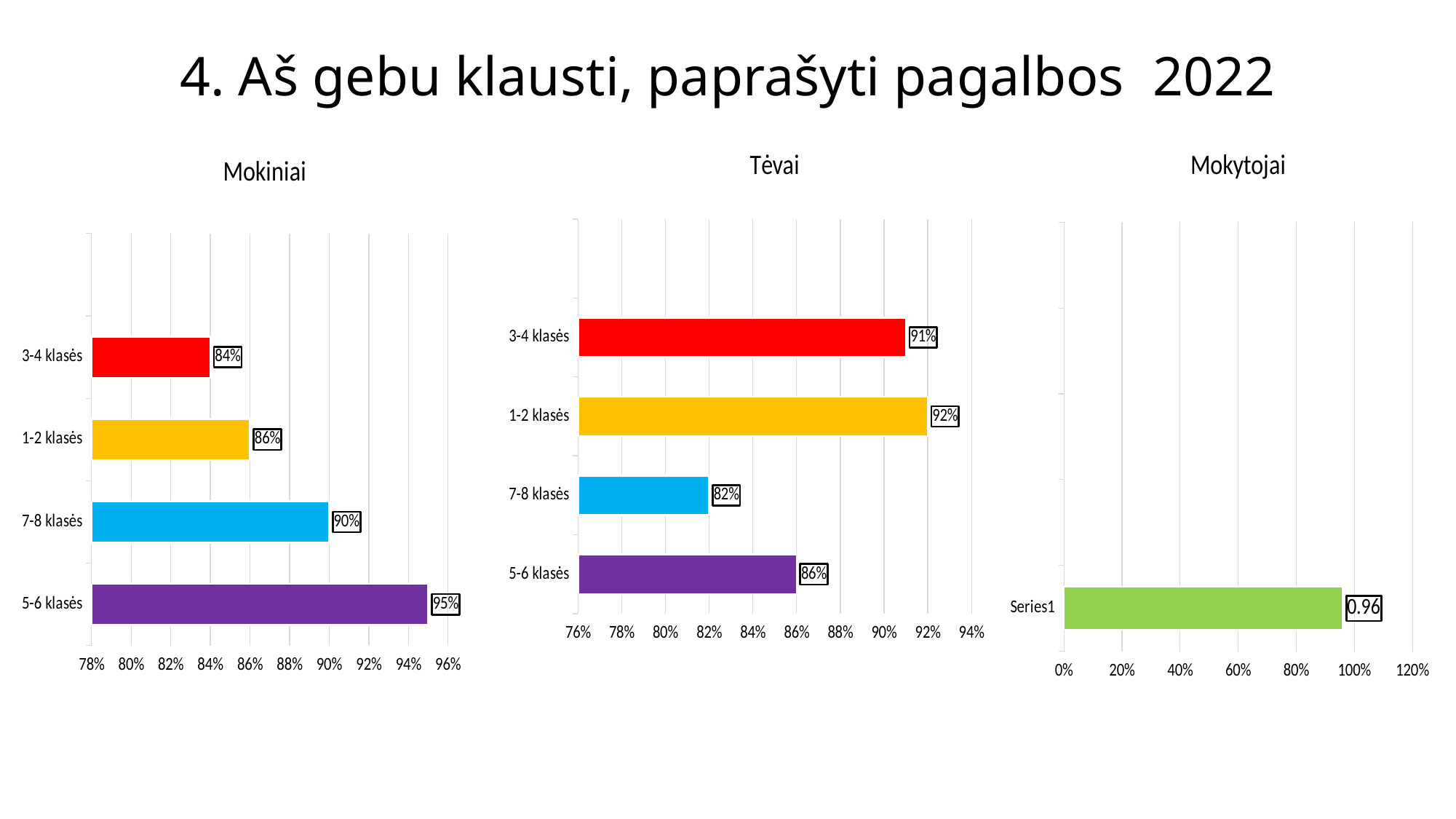
In the Tėvai chart, what is the difference between the values for 1-2 klasės and 7-8 klasės? 10% What is the title of the chart on the right of the slide? Mokytojai In the Tėvai chart, which category has the highest value? 1-2 klasės In the Mokiniai chart, is the value for 3-4 klasės greater or less than 90%? less In the Mokiniai chart, what is the value for 5-6 klasės? 95% In the Tėvai chart, which is larger, the value for 3-4 klasės or the value for 5-6 klasės? 3-4 klasės How many categories are shown in the Mokiniai chart? 4 In the Mokiniai chart, what is the difference between the values for 7-8 klasės and 1-2 klasės? 4% What kind of chart is the Tėvai chart? Bar chart In the Tėvai chart, what is the value for 7-8 klasės? 82% In the Mokiniai chart, which category has the lowest value? 3-4 klasės In the Mokytojai chart, what is the value shown for Series1? 0.96